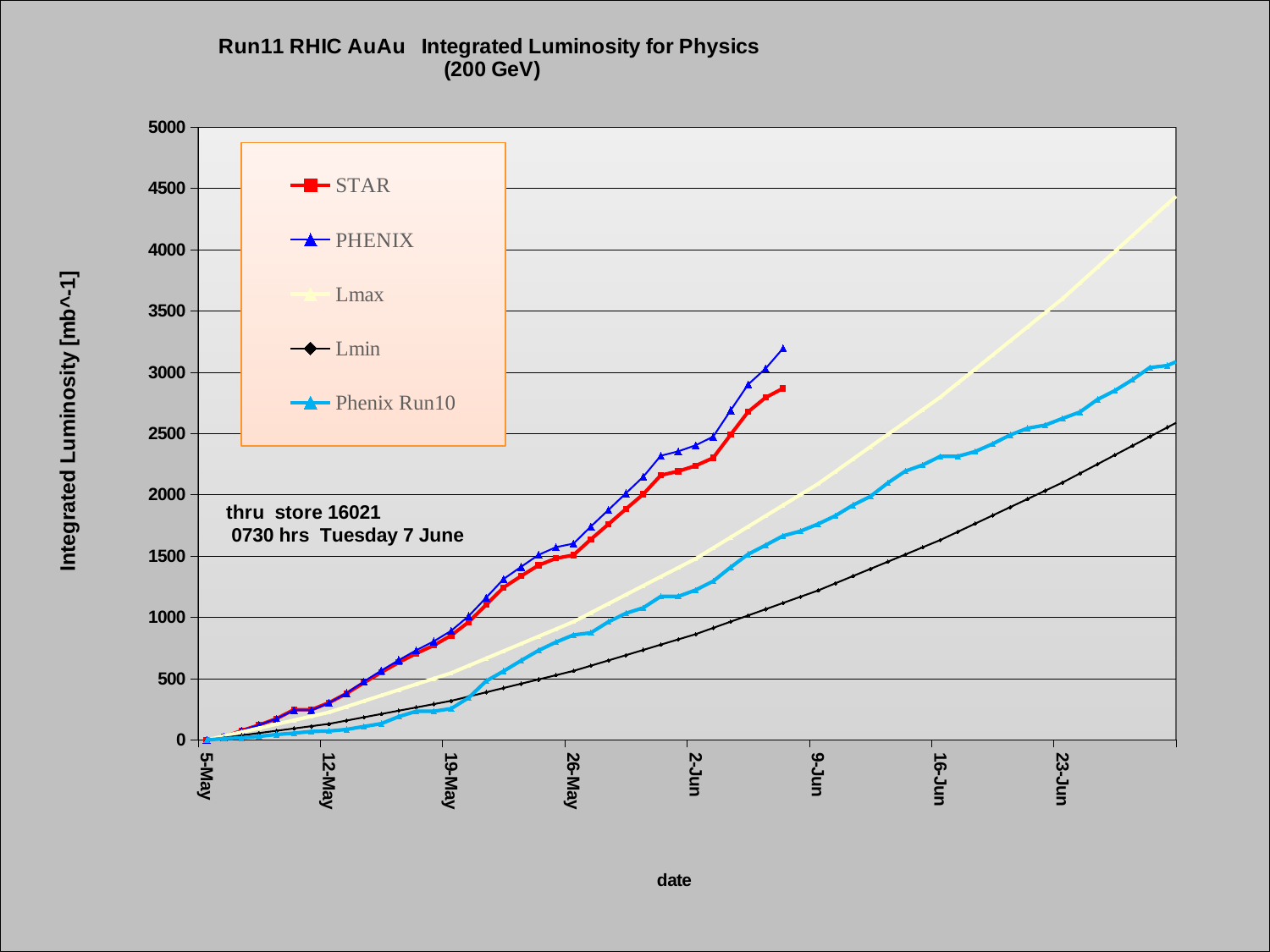
What is the title of the chart? Run11 RHIC AuAu Integrated Luminosity for Physics (200 GeV) What kind of chart is shown on the slide? line chart Do the values of the PHENIX series rise or fall along the x axis? rise Is the value of the Lmax series at the right end of the chart greater or less than 4000? greater At 16-Jun, which series has the larger value, Lmax or Lmin? Lmax Which series reaches the highest value on the chart? Lmax Is the value of the Lmin series at the right end of the chart greater or less than 2000? greater How many series does the legend list? 5 What is the label of the y axis? Integrated Luminosity [mb^-1] Is the final value of the STAR series greater or less than 3000? less At 2-Jun, which series has the larger value, PHENIX or STAR? PHENIX